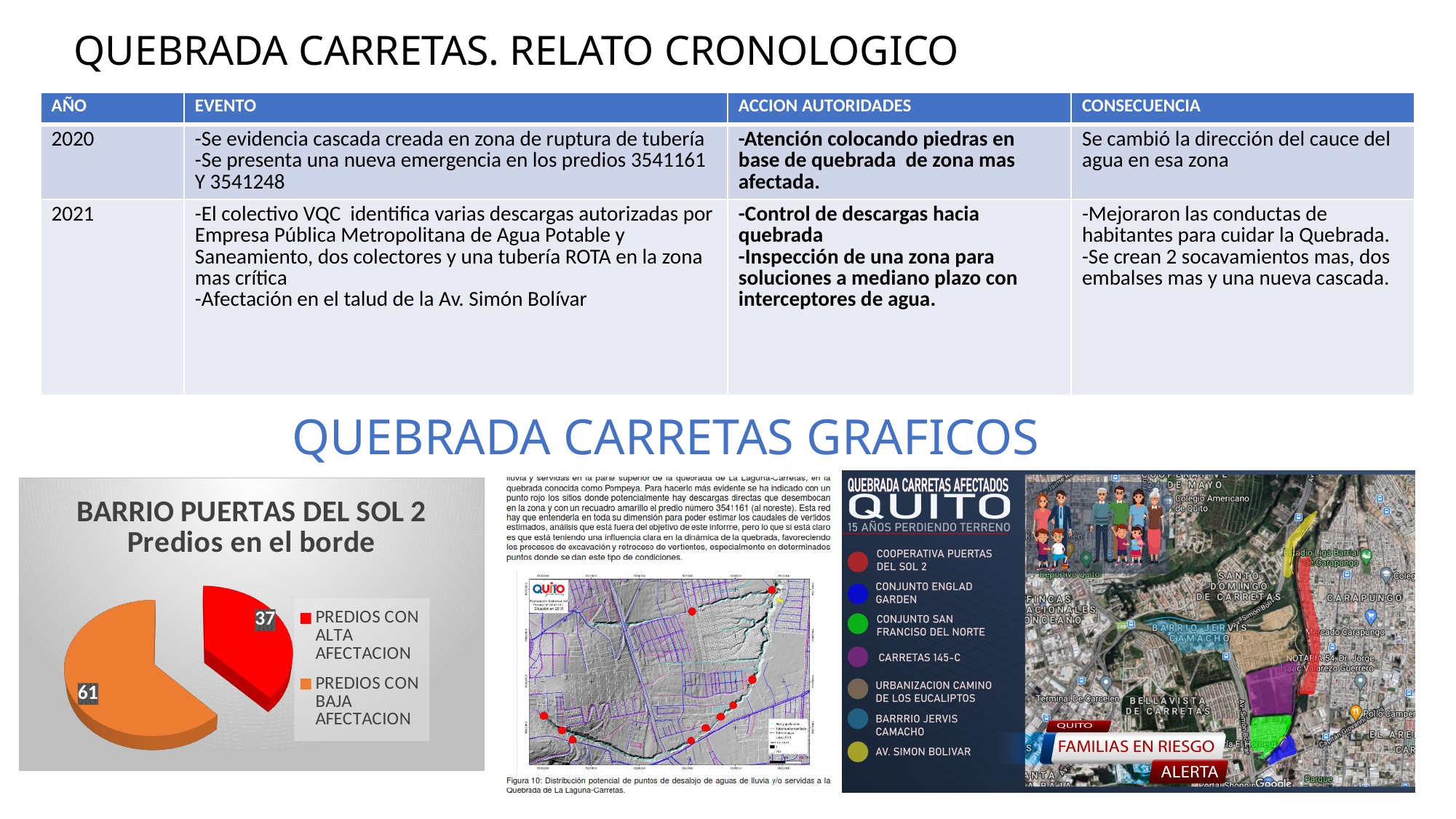
In the pie chart "BARRIO PUERTAS DEL SOL 2", what is the total of the two slice values? 98 In the pie chart "BARRIO PUERTAS DEL SOL 2", what colour is the PREDIOS CON ALTA AFECTACION slice? Red What kind of chart is shown under the title "BARRIO PUERTAS DEL SOL 2 Predios en el borde"? Pie chart In the pie chart "BARRIO PUERTAS DEL SOL 2", what is the value for PREDIOS CON BAJA AFECTACION? 61 In the pie chart "BARRIO PUERTAS DEL SOL 2", which is larger: PREDIOS CON ALTA AFECTACION or PREDIOS CON BAJA AFECTACION? PREDIOS CON BAJA AFECTACION What is the subtitle shown below "BARRIO PUERTAS DEL SOL 2" on the pie chart? Predios en el borde In the pie chart "BARRIO PUERTAS DEL SOL 2", what share of the total does PREDIOS CON BAJA AFECTACION represent, to the nearest whole percent? 62% In the pie chart "BARRIO PUERTAS DEL SOL 2", which category has the largest slice? PREDIOS CON BAJA AFECTACION In the pie chart "BARRIO PUERTAS DEL SOL 2", what is the difference between the PREDIOS CON BAJA AFECTACION and PREDIOS CON ALTA AFECTACION values? 24 In the pie chart "BARRIO PUERTAS DEL SOL 2", what is the value for PREDIOS CON ALTA AFECTACION? 37 In the pie chart "BARRIO PUERTAS DEL SOL 2", which category has the smallest slice? PREDIOS CON ALTA AFECTACION How many slices does the pie chart "BARRIO PUERTAS DEL SOL 2" have? 2